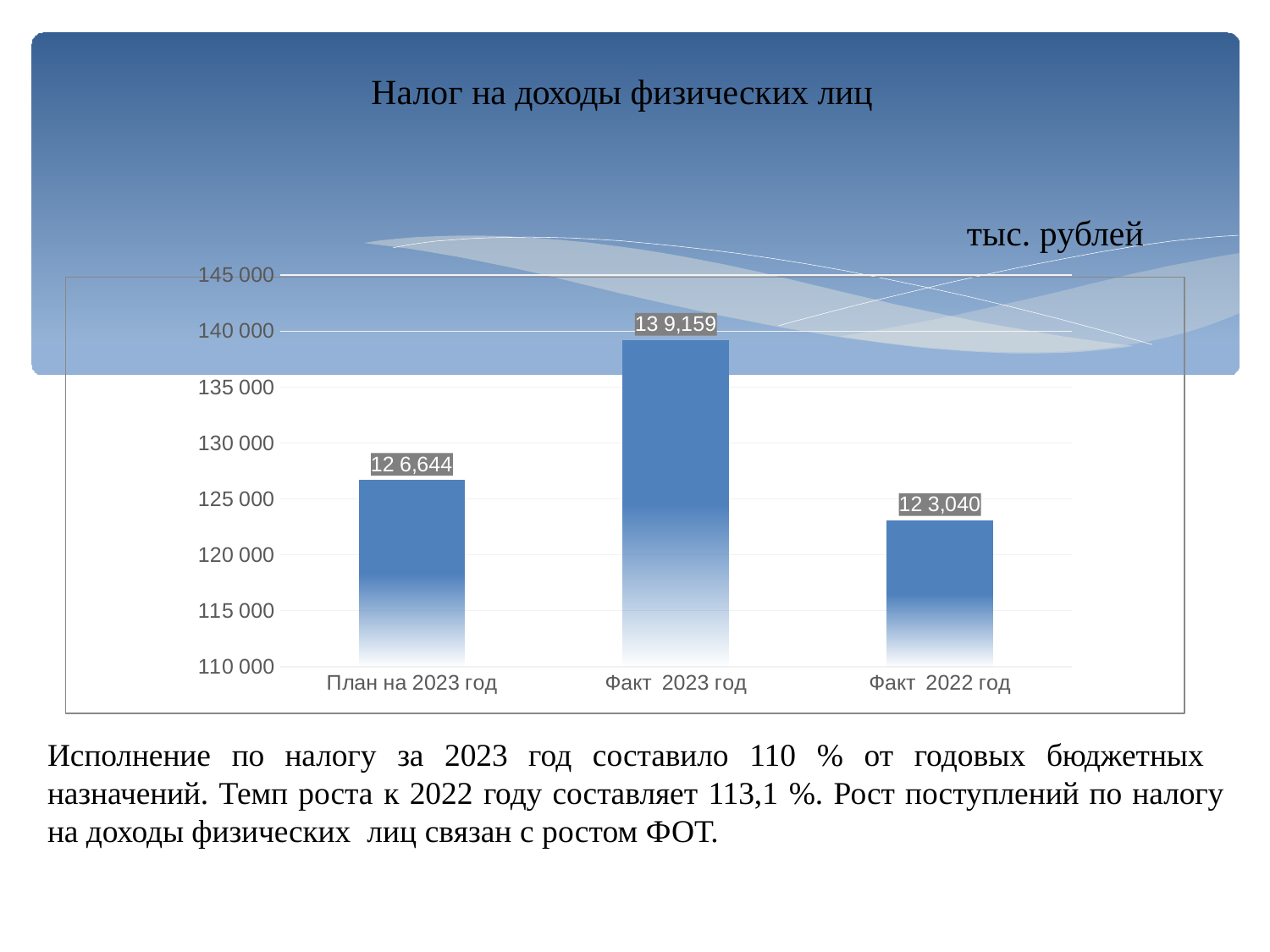
Is the value for Факт 2022 год greater or less than 125 000? less What is the difference between Факт 2023 год and План на 2023 год? 12,515 What is the value for План на 2023 год? 12 6,644 Which category has the highest value? Факт 2023 год What is the value for Факт 2023 год? 13 9,159 How many categories are shown in the chart? 3 What is the difference between Факт 2023 год and Факт 2022 год? 16,119 What is the value for Факт 2022 год? 12 3,040 Which category has the lowest value? Факт 2022 год What is the title of the chart? Налог на доходы физических лиц Which is larger, План на 2023 год or Факт 2022 год? План на 2023 год What kind of chart is shown on the slide? bar chart